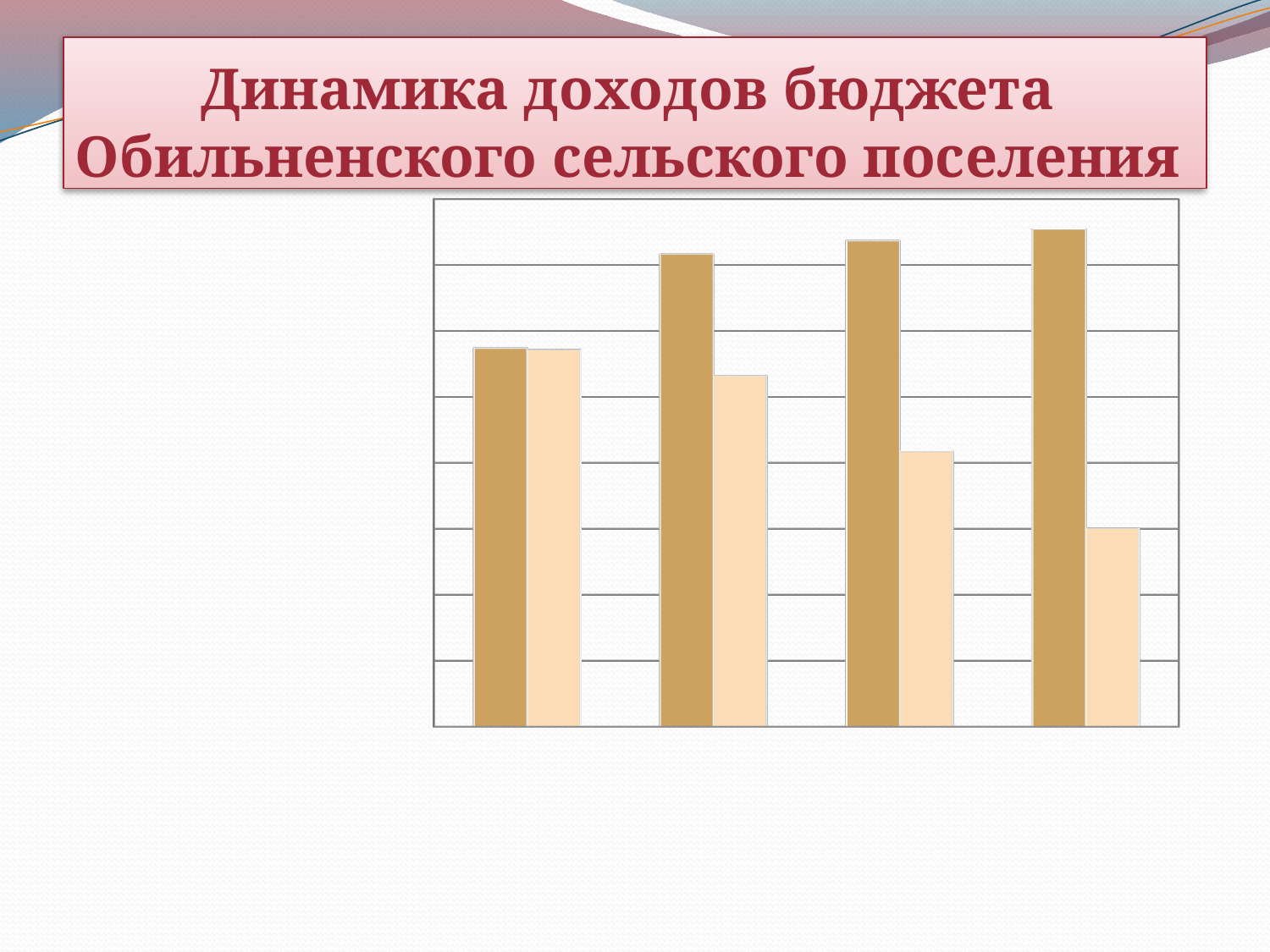
Does the chart display a legend? No In which group is the lighter bar the shortest? the rightmost (fourth) group Do the lighter (peach) bars rise or fall from left to right across the groups? fall In which group is the lighter bar the tallest? the leftmost (first) group What kind of chart is shown on the slide? bar chart Do the darker (tan) bars rise or fall from left to right across the groups? rise How many bars are there in each group? 2 How many different bar colours (series) are plotted in the chart? 2 In the rightmost group, which bar is taller, the darker one or the lighter one? the darker one What is the title shown above the chart? Динамика доходов бюджета Обильненского сельского поселения How many groups of bars does the chart contain? 4 In which group is the darker bar the tallest? the rightmost (fourth) group